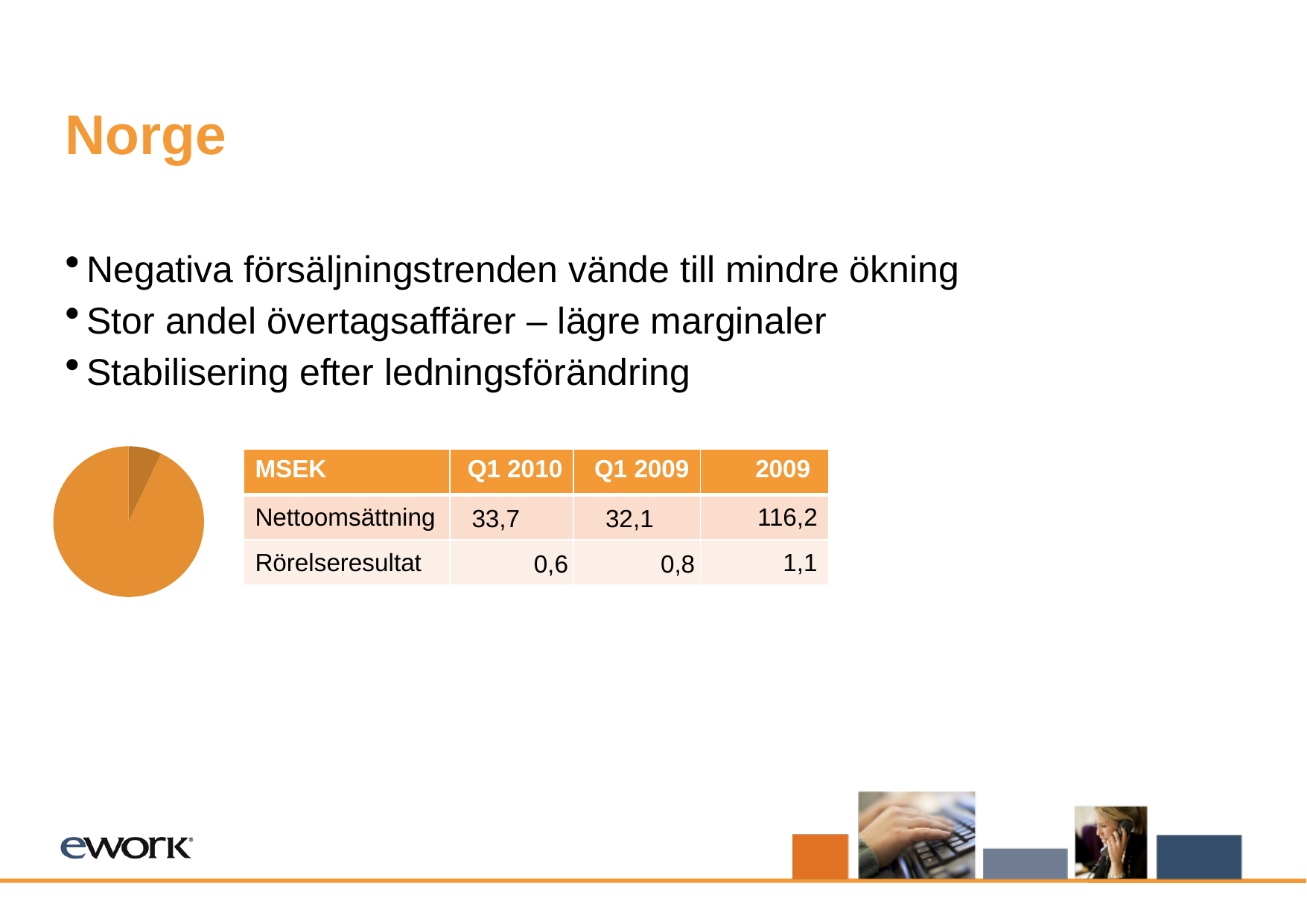
Does the pie chart display a legend? No What colour is the largest slice of the pie chart? orange Is the darker orange slice of the pie chart larger or smaller than the lighter orange slice? smaller How many slices does the pie chart have? 2 Does the smaller slice of the pie chart take up more or less than half of the pie? less What kind of chart is shown on the slide? pie chart